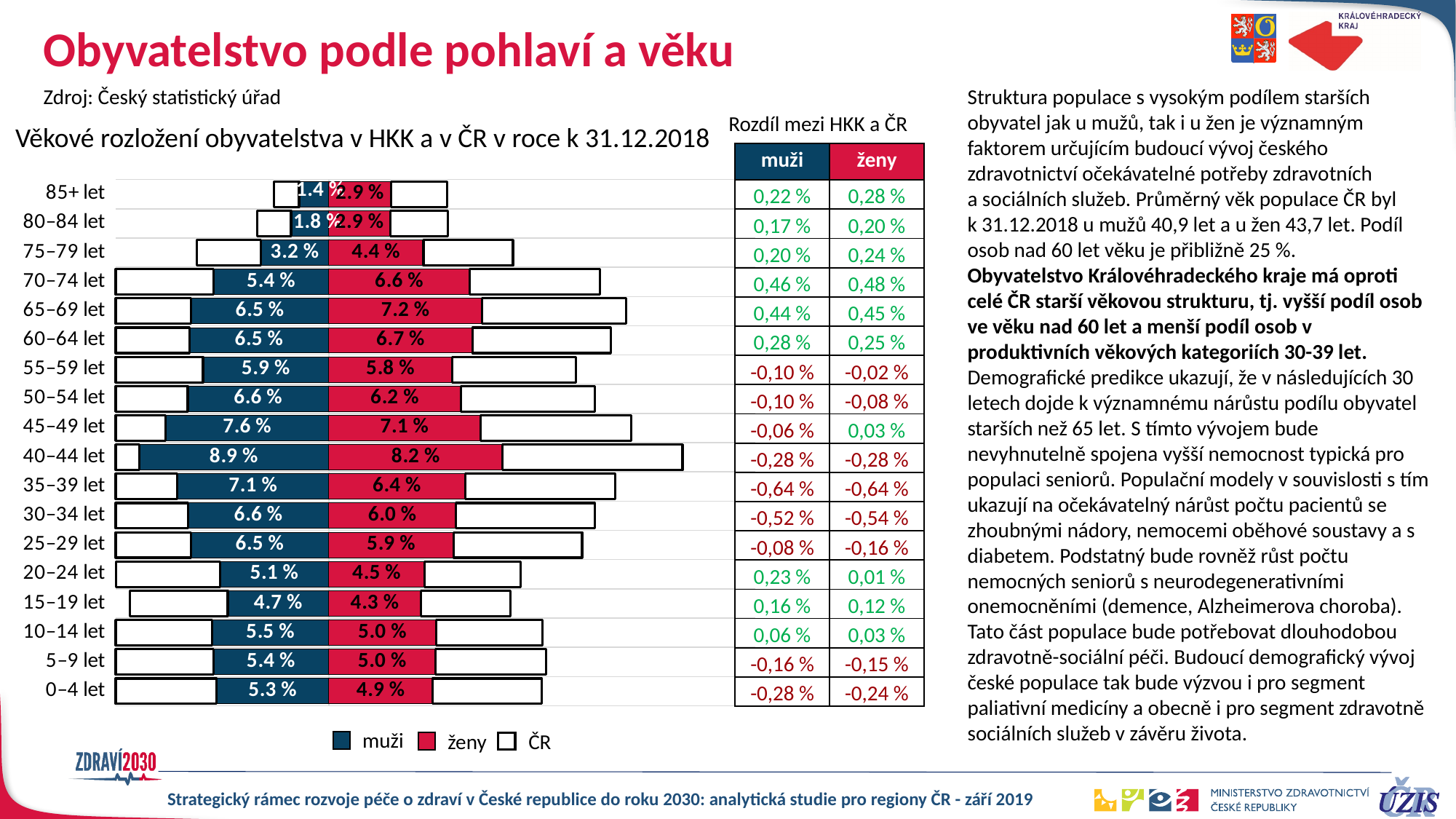
What is the difference between the muži and ženy values in the 40–44 let age group? 0.7 % What is the value for ženy in the 65–69 let age group? 7.2 % Which age group has the lowest value for muži? 85+ let How many age groups are shown on the chart? 18 What is the value for muži in the 40–44 let age group? 8.9 % How many entries does the chart legend list? 3 In the 65–69 let age group, which is larger, the value for muži or for ženy? ženy What is the value for muži in the 0–4 let age group? 5.3 % Which legend entry is shown in red? ženy Which age group has the highest value for muži? 40–44 let What is the value for ženy in the 85+ let age group? 2.9 % What kind of chart is used to show the age distribution of the population in HKK and ČR? bar chart